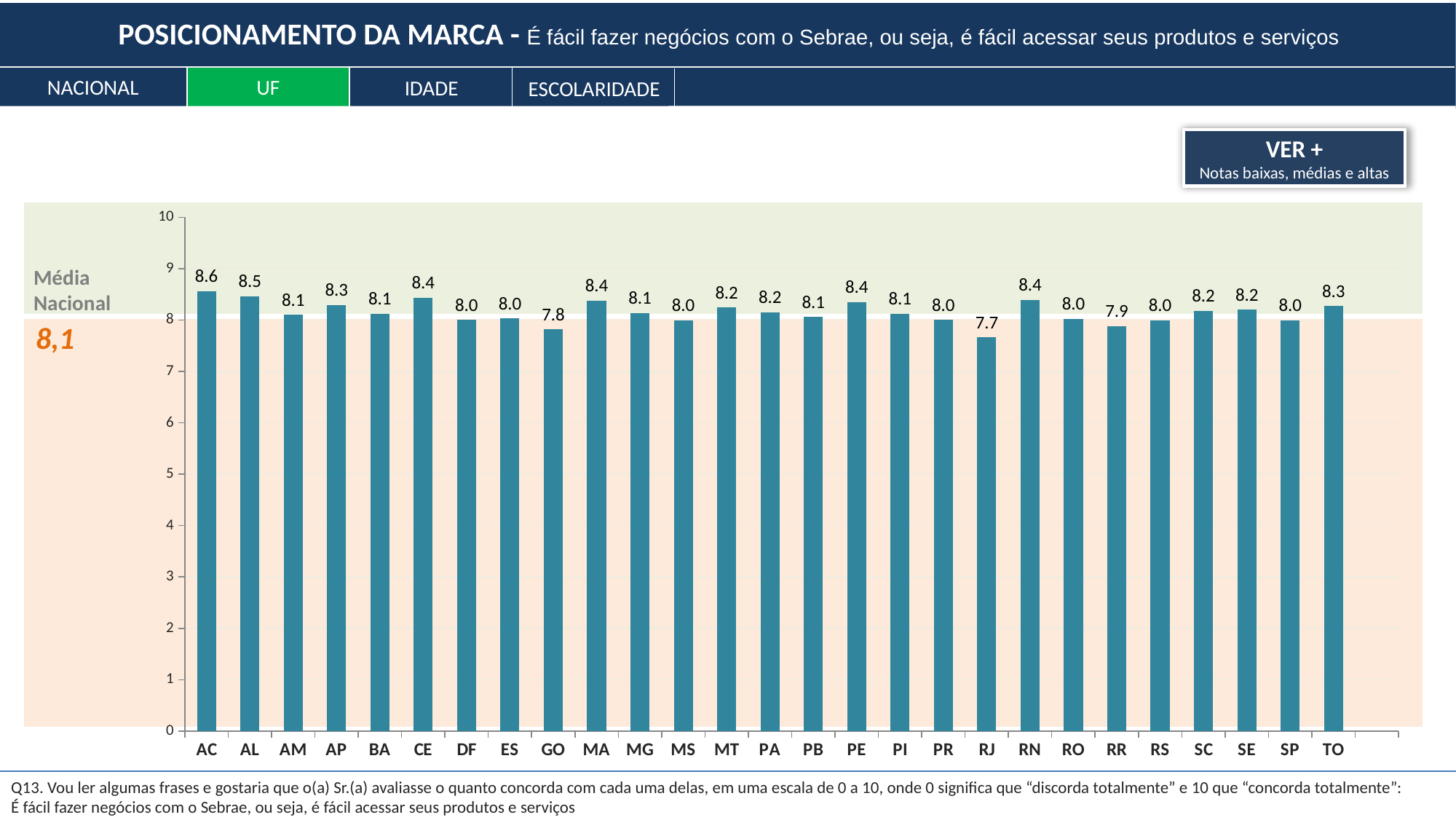
Is the value for RR greater or less than 8? less What is the value for CE? 8.4 Which state has the highest value? AC What is the Média Nacional value shown on the chart? 8,1 What is the value for RJ? 7.7 Which has a larger value, GO or AL? AL What is the difference between the values for AP and GO? 0.5 What kind of chart is shown? bar chart Which state has the lowest value? RJ What is the difference between the values for AC and RJ? 0.9 What is the value for TO? 8.3 How many states (UFs) are shown on the x axis? 27